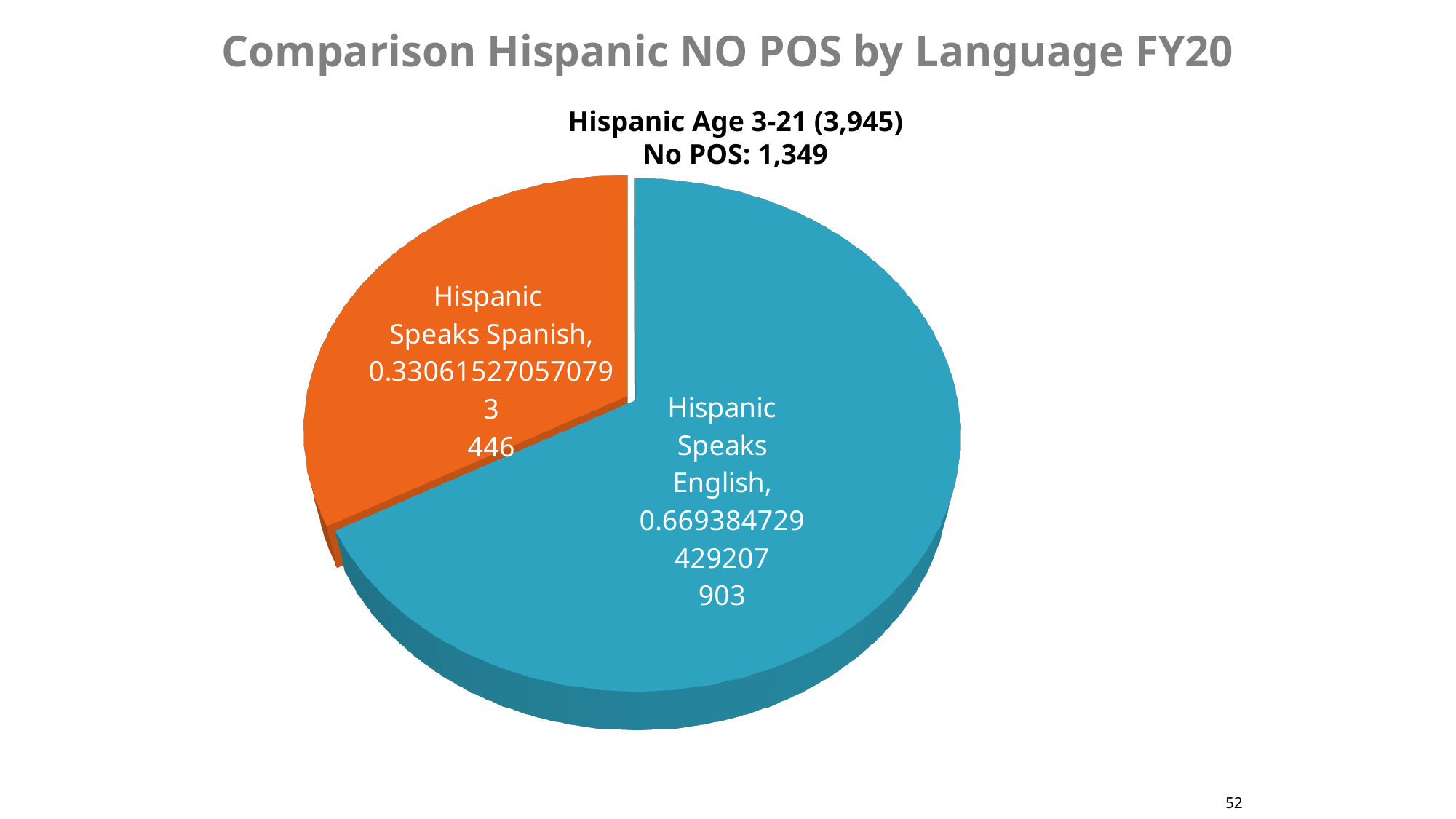
What is the count shown for the Hispanic Speaks English slice? 903 Which slice is the largest in the pie chart? Hispanic Speaks English What is the difference between the counts for Hispanic Speaks English and Hispanic Speaks Spanish? 457 How many slices does the pie chart have? 2 What is the total No POS count shown in the chart title? 1,349 What colour is the Hispanic Speaks Spanish slice? Orange What share value is printed on the Hispanic Speaks Spanish slice? 0.330615270570793 Which slice is the smallest in the pie chart? Hispanic Speaks Spanish What share value is printed on the Hispanic Speaks English slice? 0.669384729429207 What is the count shown for the Hispanic Speaks Spanish slice? 446 Which has a larger count, Hispanic Speaks English or Hispanic Speaks Spanish? Hispanic Speaks English What kind of chart is shown on the slide? Pie chart